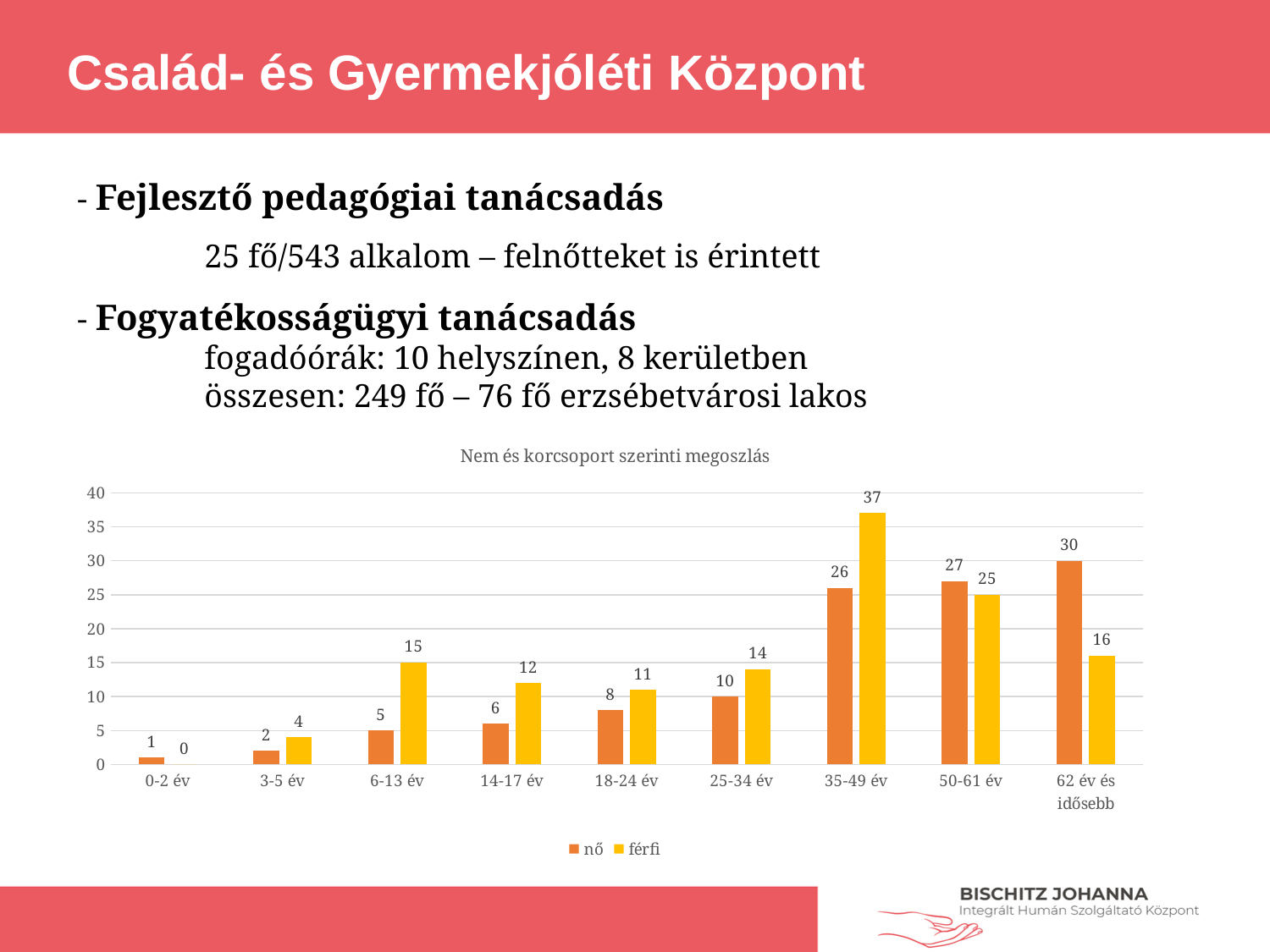
What is the value for nő in the 35-49 év category? 26 In the 50-61 év category, which is larger, nő or férfi? nő What is the total of nő and férfi in the 18-24 év category? 19 What is the value for nő in the 62 év és idősebb category? 30 What kind of chart is shown on the slide? bar chart What is the difference between the férfi and nő values in the 35-49 év category? 11 Which age category has the lowest nő value? 0-2 év How many series does the legend list? 2 How many age categories are shown on the x axis? 9 Which age category has the highest férfi value? 35-49 év What is the value for férfi in the 6-13 év category? 15 What is the title of the chart? Nem és korcsoport szerinti megoszlás